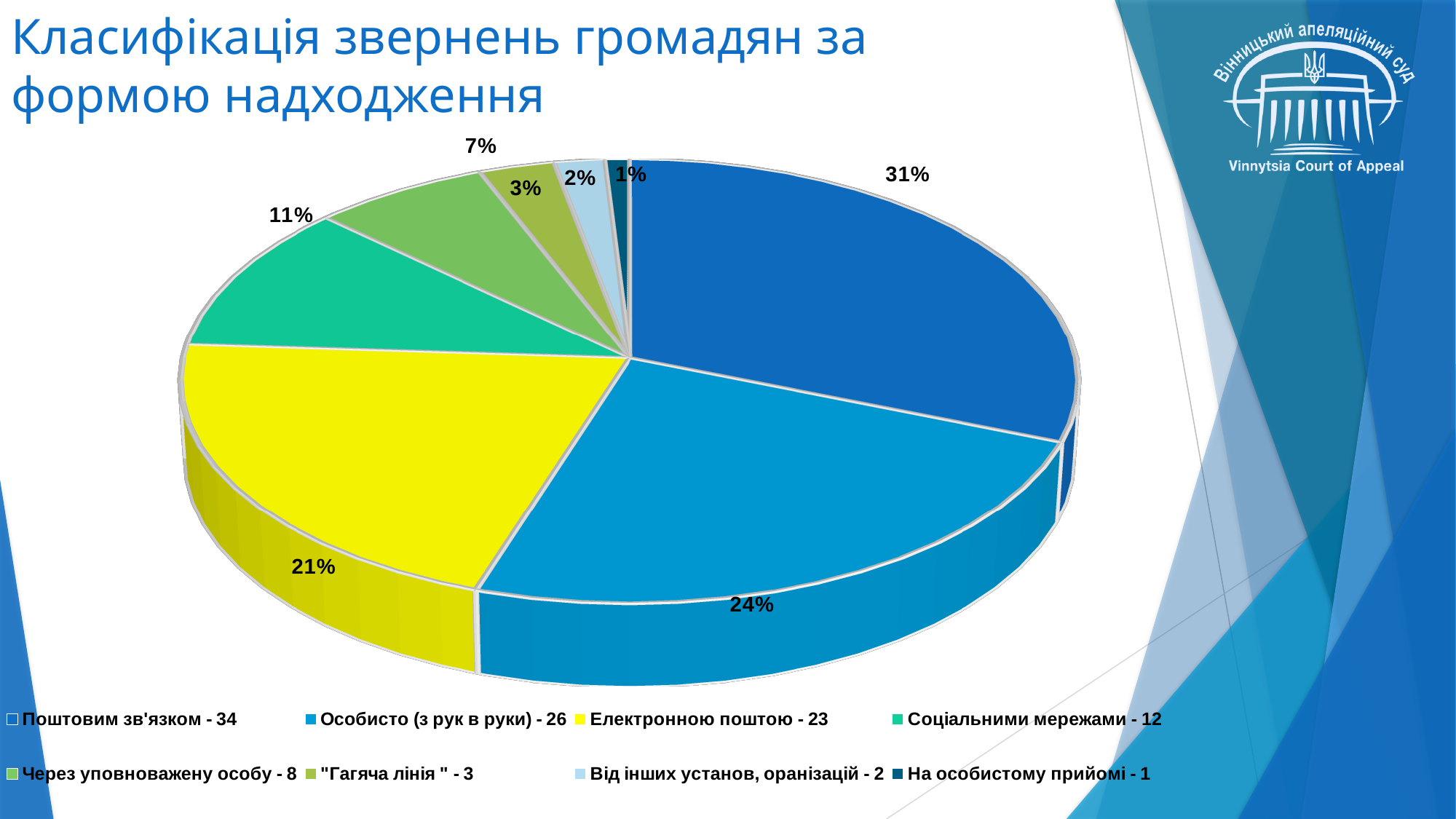
Which category has the largest slice of the pie? Поштовим зв'язком What share of the pie does "Через уповноважену особу" represent? 7% Which category has the smallest slice of the pie? На особистому прийомі According to the legend, how many appeals were received via "Гагяча лінія"? 3 What share of the pie does "Соціальними мережами" represent? 11% What is the difference in percentage points between the "Поштовим зв'язком" slice (31%) and the "Особисто (з рук в руки)" slice (24%)? 7 percentage points What share of the pie does "Особисто (з рук в руки)" represent? 24% How many categories (slices) does the pie chart have? 8 Which is larger: the share for "Електронною поштою" or the share for "Соціальними мережами"? Електронною поштою What type of chart is shown on the slide? pie chart